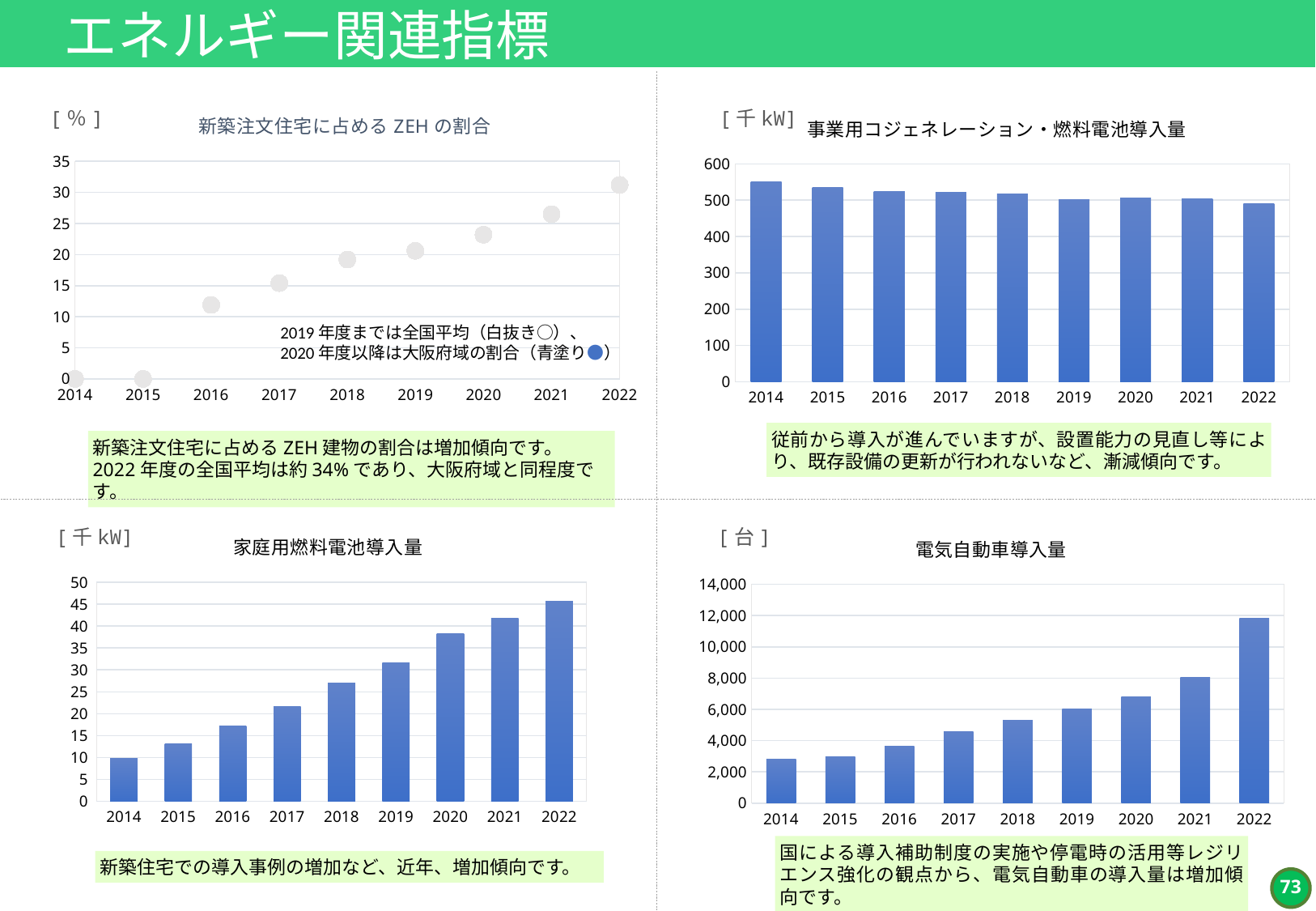
What kind of chart is the 事業用コジェネレーション・燃料電池導入量 chart? bar chart In the 電気自動車導入量 chart, which year has the highest value? 2022 In the 電気自動車導入量 chart, which is larger, the value for 2020 or the value for 2021? 2021 In the 事業用コジェネレーション・燃料電池導入量 chart, do the values generally rise or fall from 2014 to 2022? fall How many years are plotted in the 家庭用燃料電池導入量 chart? 9 In the 新築注文住宅に占める ZEH の割合 chart, do the values rise or fall from 2016 to 2022? rise In the 事業用コジェネレーション・燃料電池導入量 chart, which year has the lowest value? 2022 In the 家庭用燃料電池導入量 chart, which year has the lowest value? 2014 In the 電気自動車導入量 chart, is the value for 2022 greater or less than 10,000? greater In the 事業用コジェネレーション・燃料電池導入量 chart, which year has the highest value? 2014 In the 家庭用燃料電池導入量 chart, is the value for 2022 greater or less than 40? greater In the 事業用コジェネレーション・燃料電池導入量 chart, is the value for 2022 greater or less than 500? less